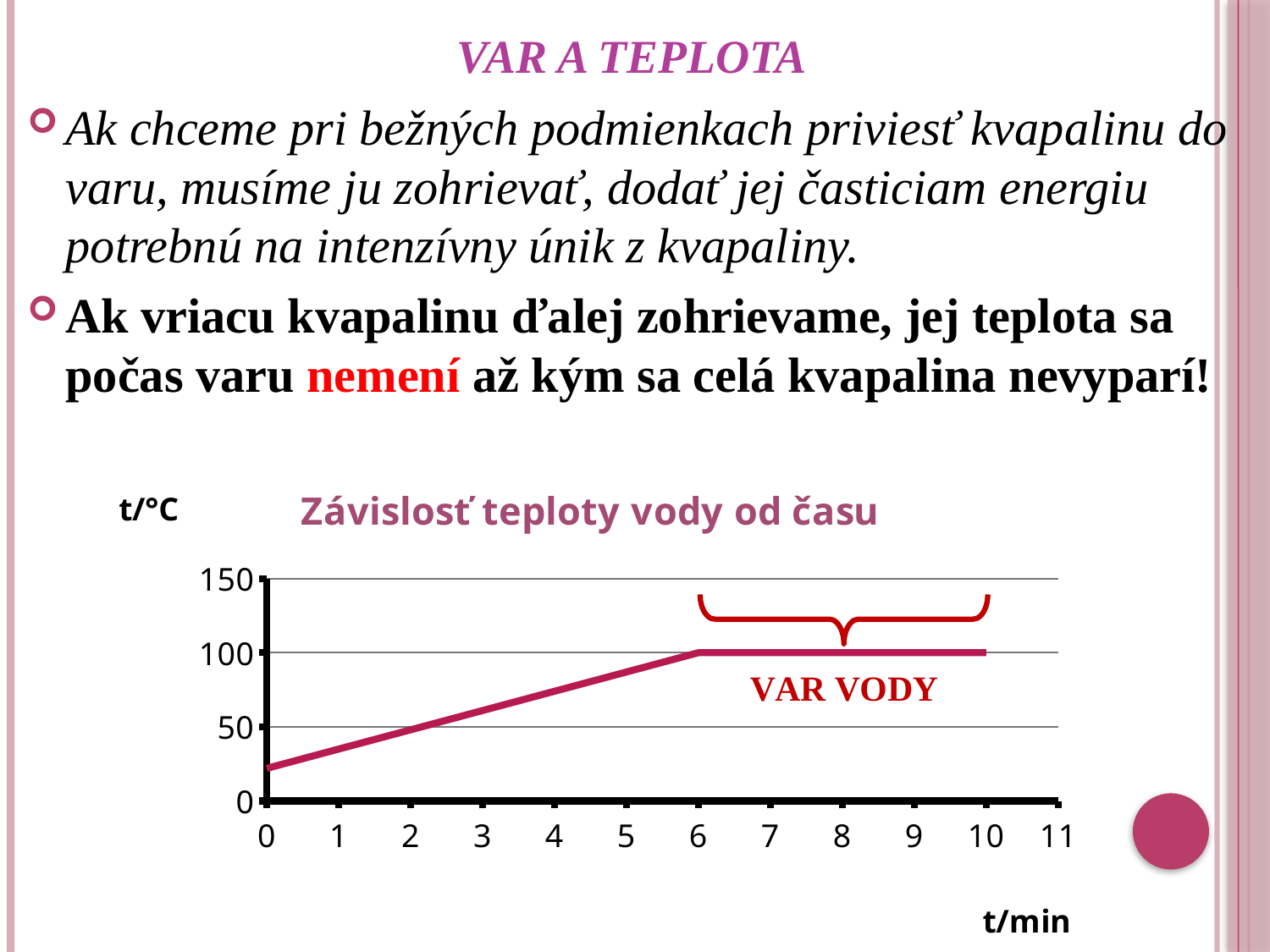
What is the title of the chart? Závislosť teploty vody od času Is the temperature at 5 min greater or less than 100? less Which is larger, the temperature at 3 min or at 8 min? 8 min Is the temperature at 4 min greater or less than 50? greater What kind of chart is shown on the slide? line chart Does the temperature change between 6 min and 10 min? no, it stays constant What is the highest temperature value reached by the line? 100 Is the temperature at 1 min greater or less than 50? less What is the temperature value at 10 min? 100 Does the temperature rise or fall between 0 min and 6 min? rise What is the temperature value at 6 min? 100 What label is written on the x axis of the chart? t/min